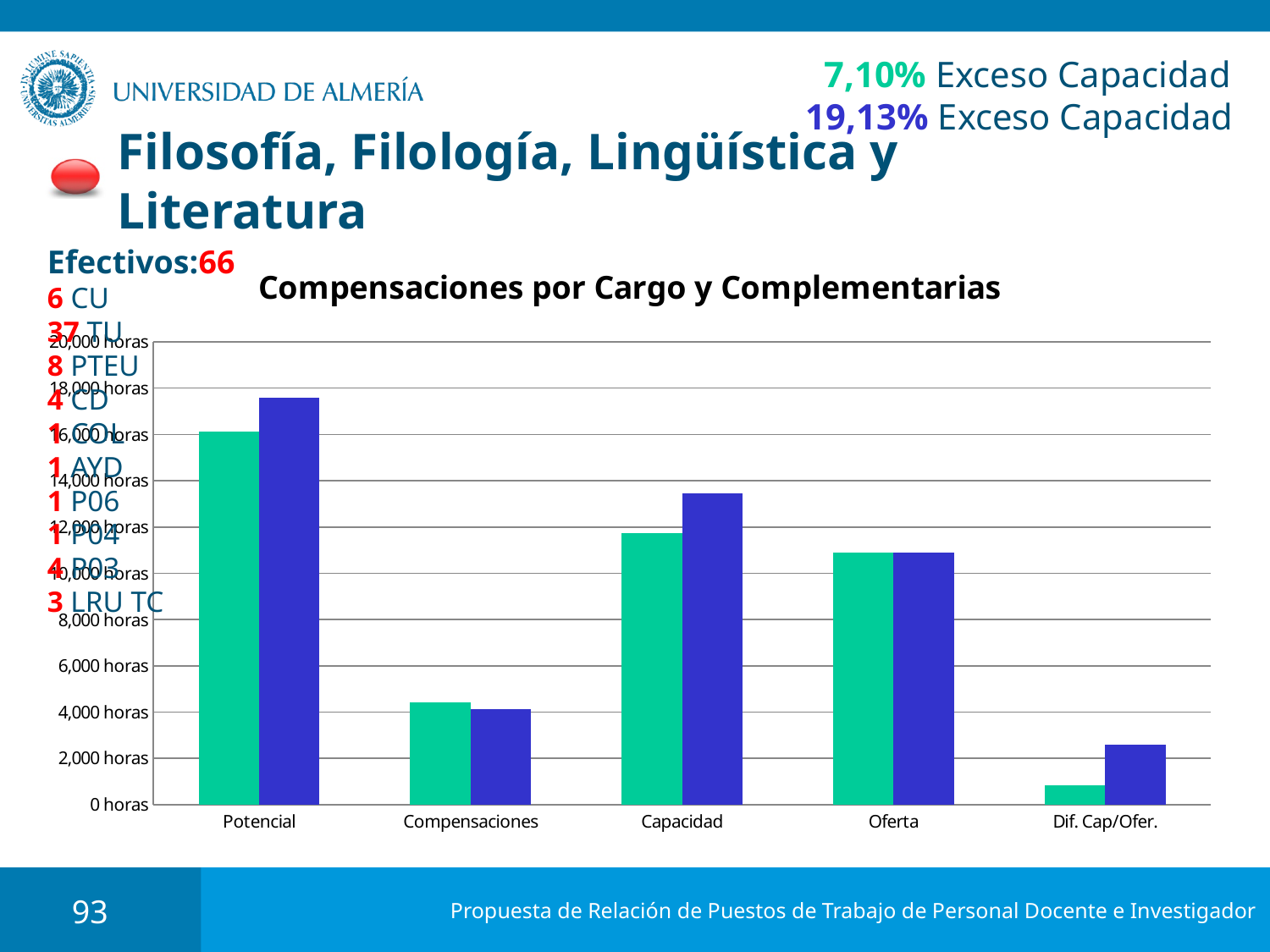
Is the value of the green bar for Potencial greater or less than 14,000 horas? greater What unit is shown on the y axis of the chart? horas How many categories are shown on the x axis of the chart? 5 For Capacidad, which bar is taller, the green one or the blue one? the blue one Is the value of the blue bar for Capacidad greater or less than 12,000 horas? greater What is the title of the chart? Compensaciones por Cargo y Complementarias What kind of chart is shown on the slide? bar chart Which category has the larger green bar, Compensaciones or Oferta? Oferta Is the value of the green bar for Dif. Cap/Ofer. greater or less than 2,000 horas? less Which category has the shortest bar in the chart? Dif. Cap/Ofer. Which category has the tallest bar in the chart? Potencial